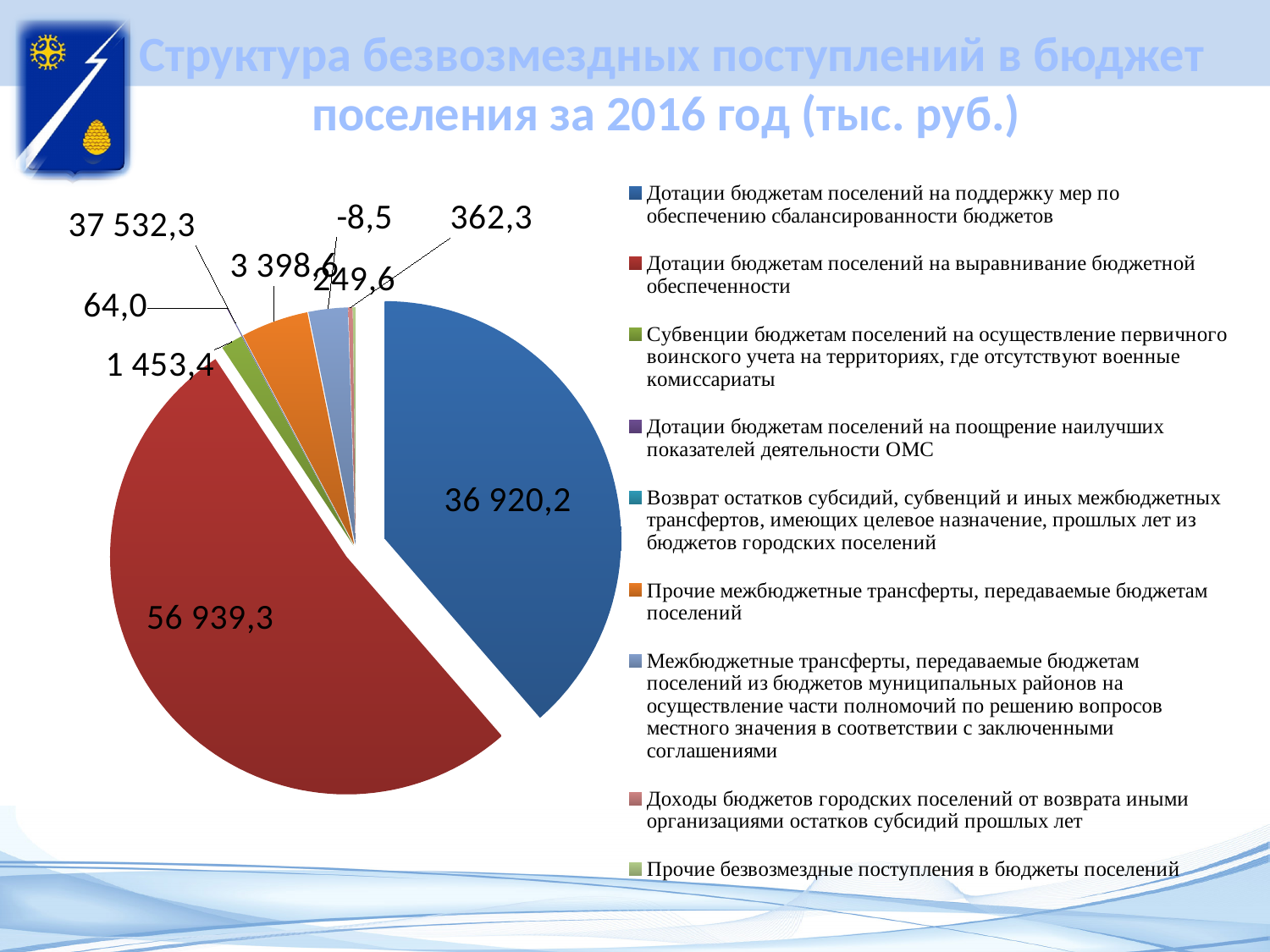
How many entries does the chart legend list? 9 What is the value for 'Дотации бюджетам поселений на поддержку мер по обеспечению сбалансированности бюджетов'? 36 920,2 What is the value of the largest slice of the pie? 56 939,3 What is the title of the chart on the slide? Структура безвозмездных поступлений в бюджет поселения за 2016 год (тыс. руб.) What is the smallest value printed as a data label on the pie chart? -8,5 What is the value for 'Прочие межбюджетные трансферты, передаваемые бюджетам поселений'? 3 398,6 Which is larger: the slice for 'Дотации бюджетам поселений на выравнивание бюджетной обеспеченности' or the slice for 'Дотации бюджетам поселений на поддержку мер по обеспечению сбалансированности бюджетов'? Дотации бюджетам поселений на выравнивание бюджетной обеспеченности Which category has the largest slice of the pie? Дотации бюджетам поселений на выравнивание бюджетной обеспеченности What kind of chart is shown on the slide? pie chart What is the difference between the two largest slices, 56 939,3 and 36 920,2? 20 019,1 What colour is the largest slice of the pie? red